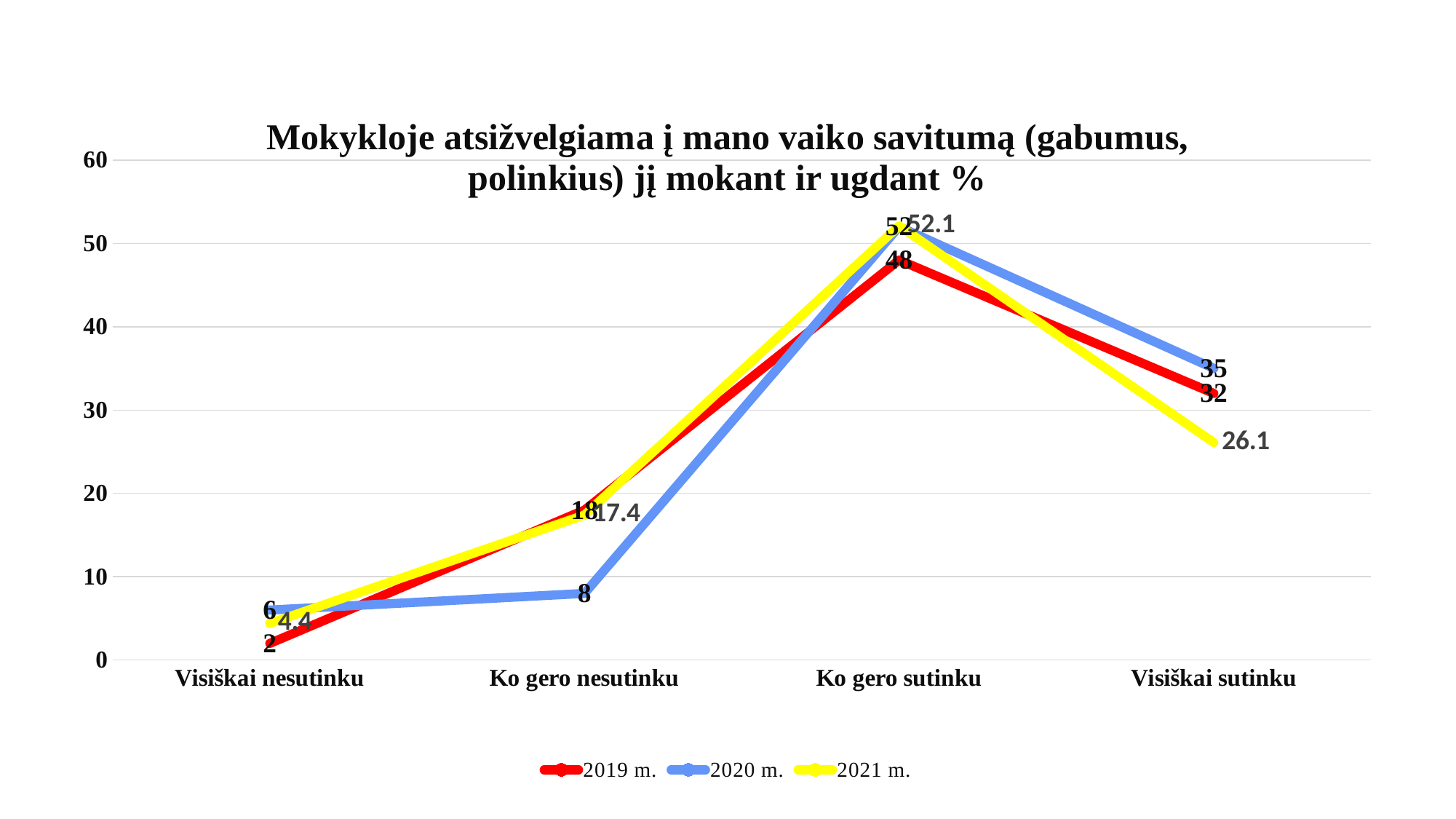
Which category has the lowest value for the 2019 m. series? Visiškai nesutinku What is the value for 2019 m. at "Ko gero sutinku"? 48 Which category has the highest value for the 2020 m. series? Ko gero sutinku How many categories are shown on the x axis? 4 What is the value for 2021 m. at "Visiškai sutinku"? 26.1 How many series does the legend list? 3 Which colour represents the 2021 m. series? yellow What is the value for 2021 m. at "Visiškai nesutinku"? 4.4 What is the value for 2020 m. at "Ko gero nesutinku"? 8 What is the difference between the 2020 m. and 2019 m. values at "Visiškai sutinku"? 3 At "Ko gero nesutinku", which series has the larger value, 2019 m. or 2020 m.? 2019 m. What type of chart is shown on the slide? line chart